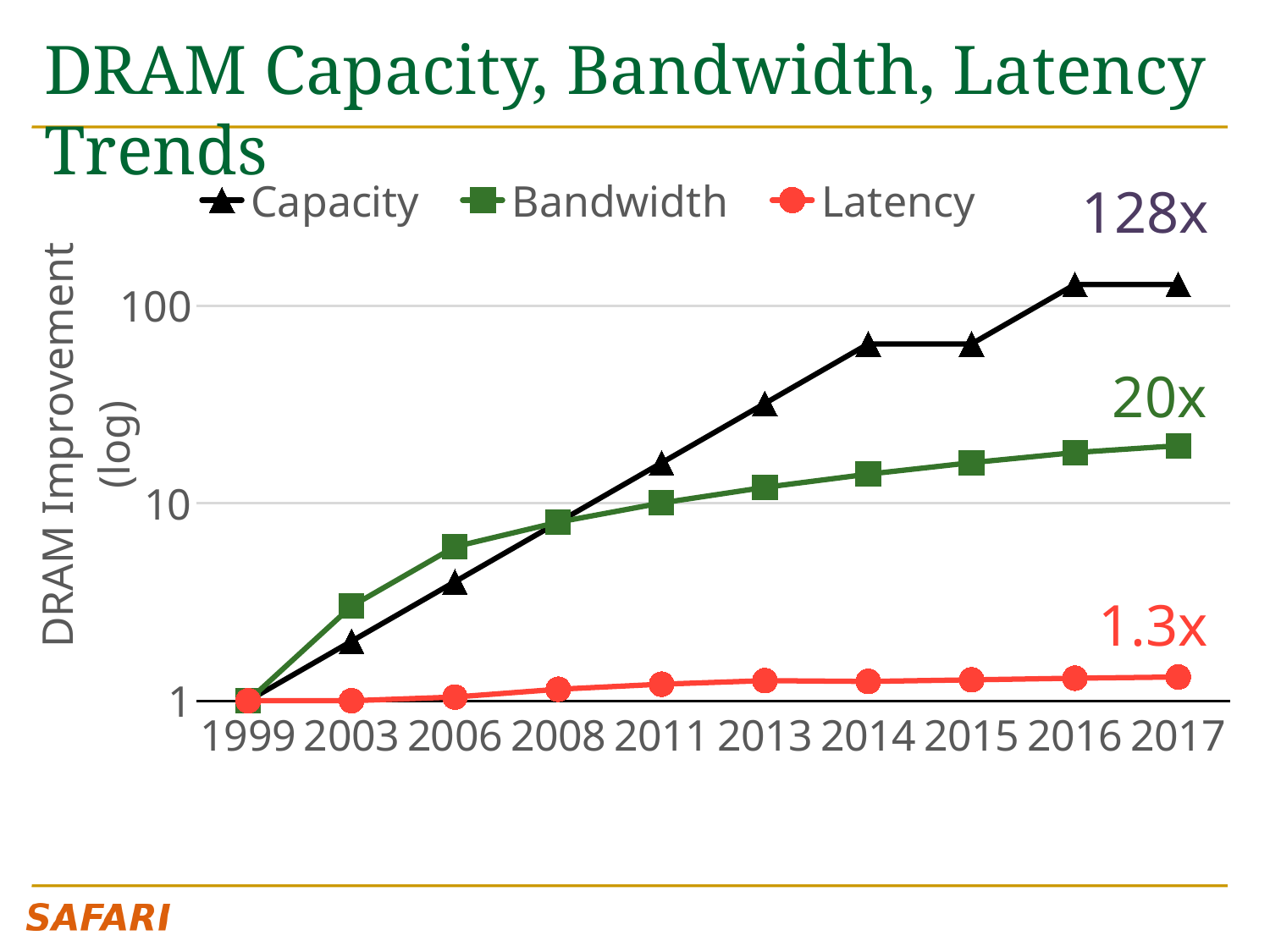
How many series does the legend list? 3 Which series has the lowest value in 2017? Latency Which series has the highest value in 2017? Capacity What improvement factor is labelled for Bandwidth in 2017? 20x Does the Capacity series rise or fall from 1999 to 2017? rise What is the label on the y axis? DRAM Improvement (log) How many years are labelled along the x axis? 10 What improvement factor is labelled for Latency in 2017? 1.3x Is the Capacity value for 2016 greater or less than 100? greater What improvement factor is labelled for Capacity in 2017? 128x What kind of chart is shown on the slide? line chart In 2006, which is larger, the Bandwidth value or the Capacity value? Bandwidth